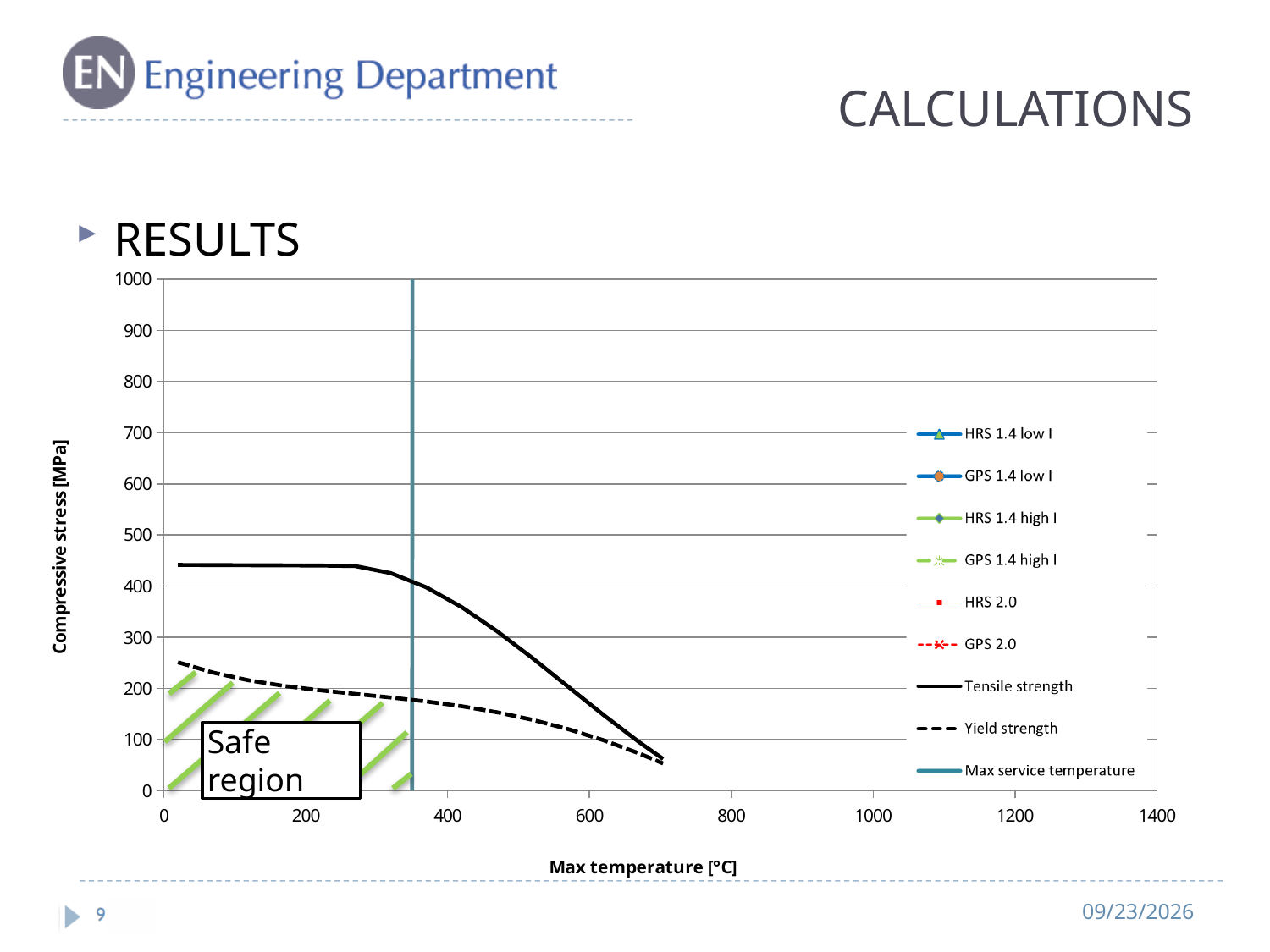
Is the Tensile strength value at 600°C greater or less than 300 MPa? less Does the Yield strength curve rise or fall as Max temperature increases? fall At 400°C, which is larger: Tensile strength or Yield strength? Tensile strength Is the Yield strength value at 400°C greater or less than 200 MPa? less Is the Max service temperature line located at a temperature greater or less than 400°C? less Does the Tensile strength curve rise or fall as Max temperature increases beyond 300°C? fall At 100°C, which is larger: Yield strength or Tensile strength? Tensile strength What text is written in the box over the green hatched area of the chart? Safe region What kind of chart is shown on the slide? line chart What is the title of the vertical axis of the chart? Compressive stress [MPa] How many series does the legend list? 9